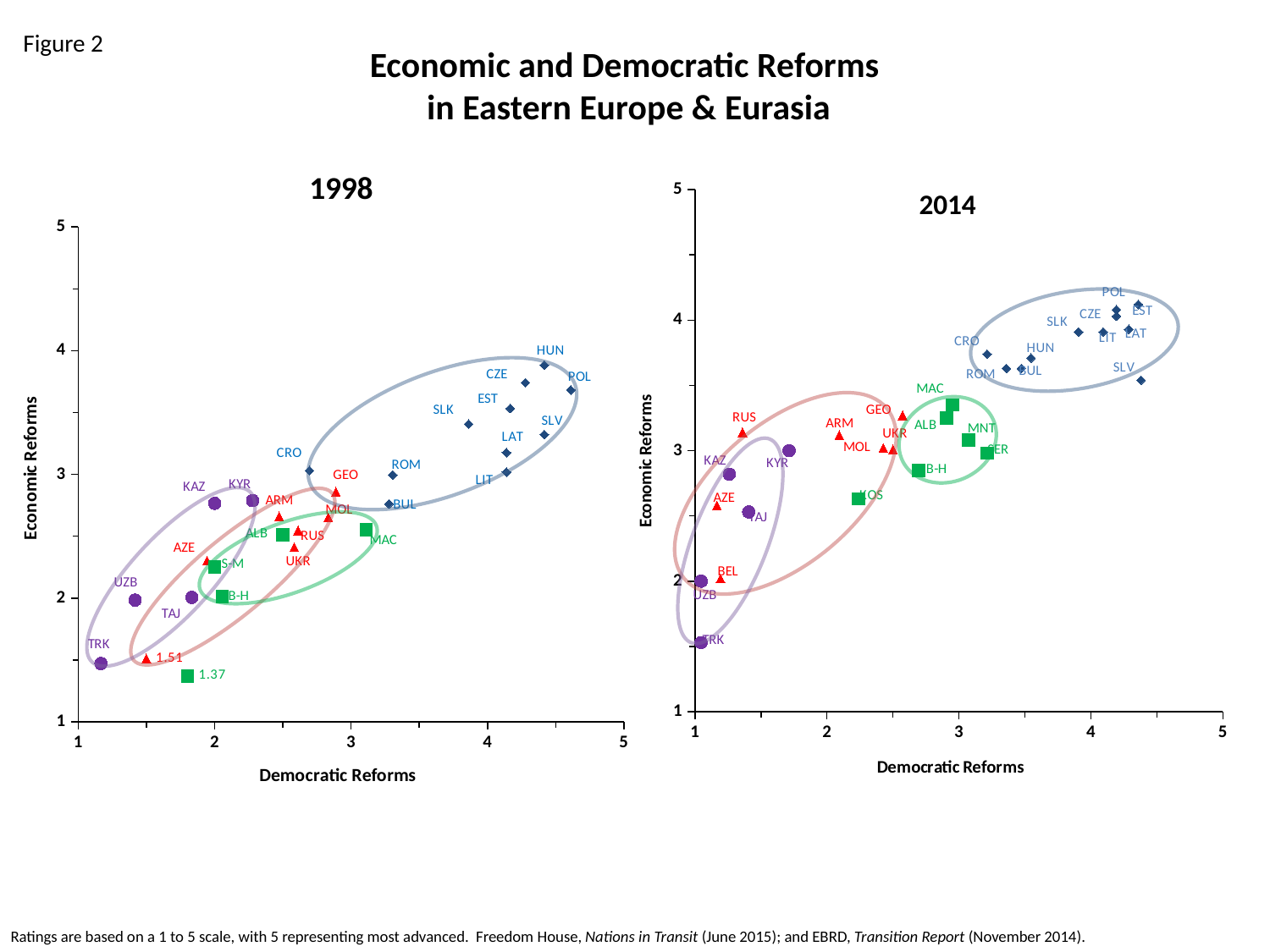
In the 1998 chart, what value is printed as a data label next to the red triangle at the bottom left? 1.51 What is the label on the horizontal axis of the 2014 chart? Democratic Reforms In the 2014 chart, which has the higher Economic Reforms rating, RUS or KOS? RUS In the 1998 chart, is the Economic Reforms value for HUN greater or less than 3? greater How many charts are shown on the slide? 2 What kind of chart is the 1998 chart on the slide? scatter chart In the 1998 chart, which country has the highest Economic Reforms rating? HUN In the 1998 chart, what value is printed as a data label next to the green square at the bottom left? 1.37 In the 2014 chart, is the Democratic Reforms value for UZB greater or less than 2? less In the 2014 chart, is the Economic Reforms value for POL greater or less than 4? greater In the 1998 chart, which country has the lowest Democratic Reforms rating? TRK In the 2014 chart, which country has the lowest Economic Reforms rating? TRK